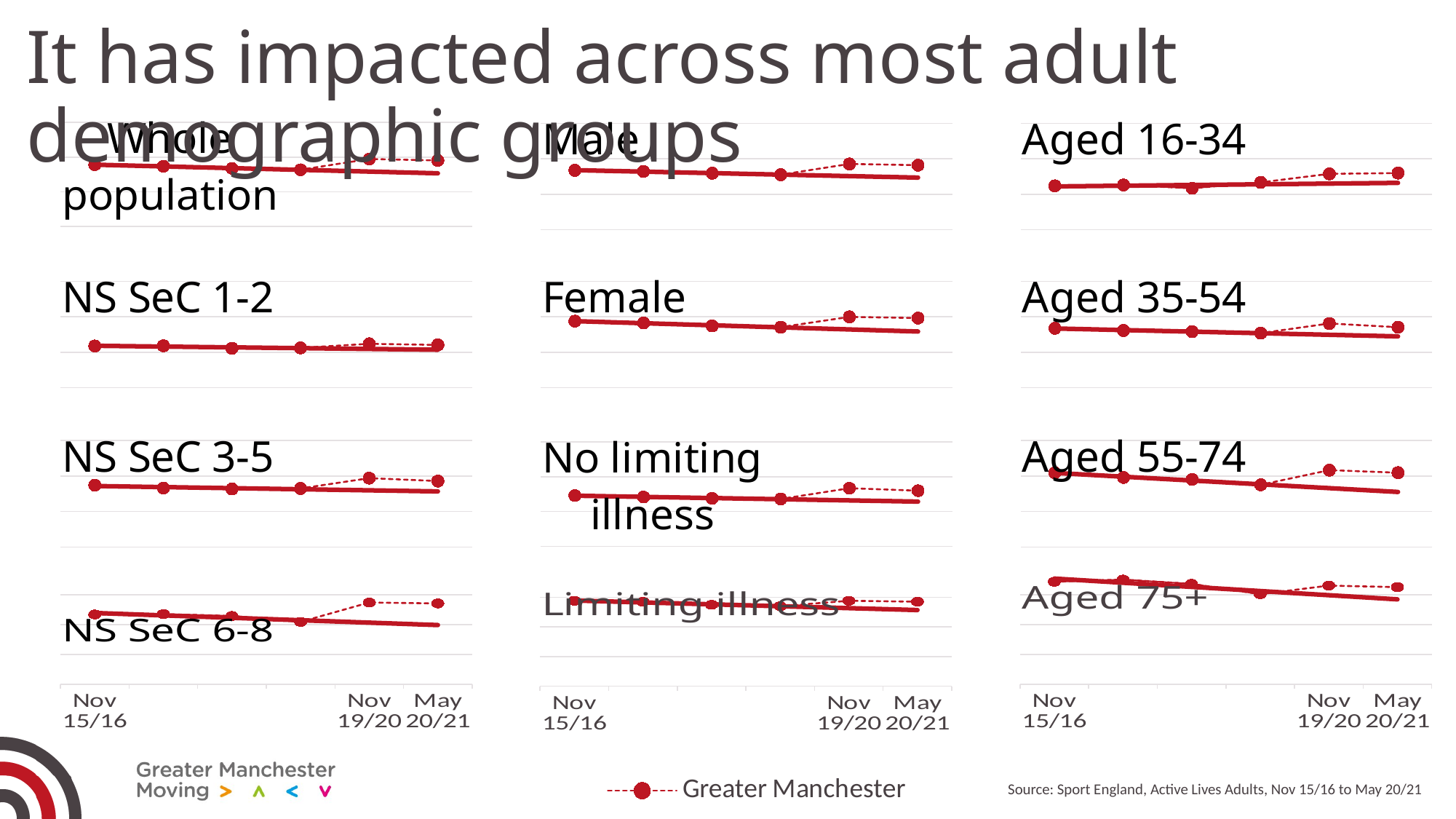
What kind of charts are shown on the slide? Line charts In the Male chart, does the trend line rise or fall across the x axis? Fall In the Female chart, which point is higher: Nov 15/16 or Nov 19/20? Nov 19/20 In the Aged 16-34 chart, does the trend line rise or fall from Nov 15/16 to May 20/21? Rise In the Aged 16-34 chart, how many data points are plotted? 6 In the NS SeC 6-8 chart, does the trend line rise or fall across the x axis? Fall What series name is shown in the legend? Greater Manchester In the Aged 16-34 chart, which point is higher: Nov 15/16 or May 20/21? May 20/21 What is the first x-axis label shown on each chart? Nov 15/16 How many series does the legend list? 1 How many small charts are shown on the slide? 12